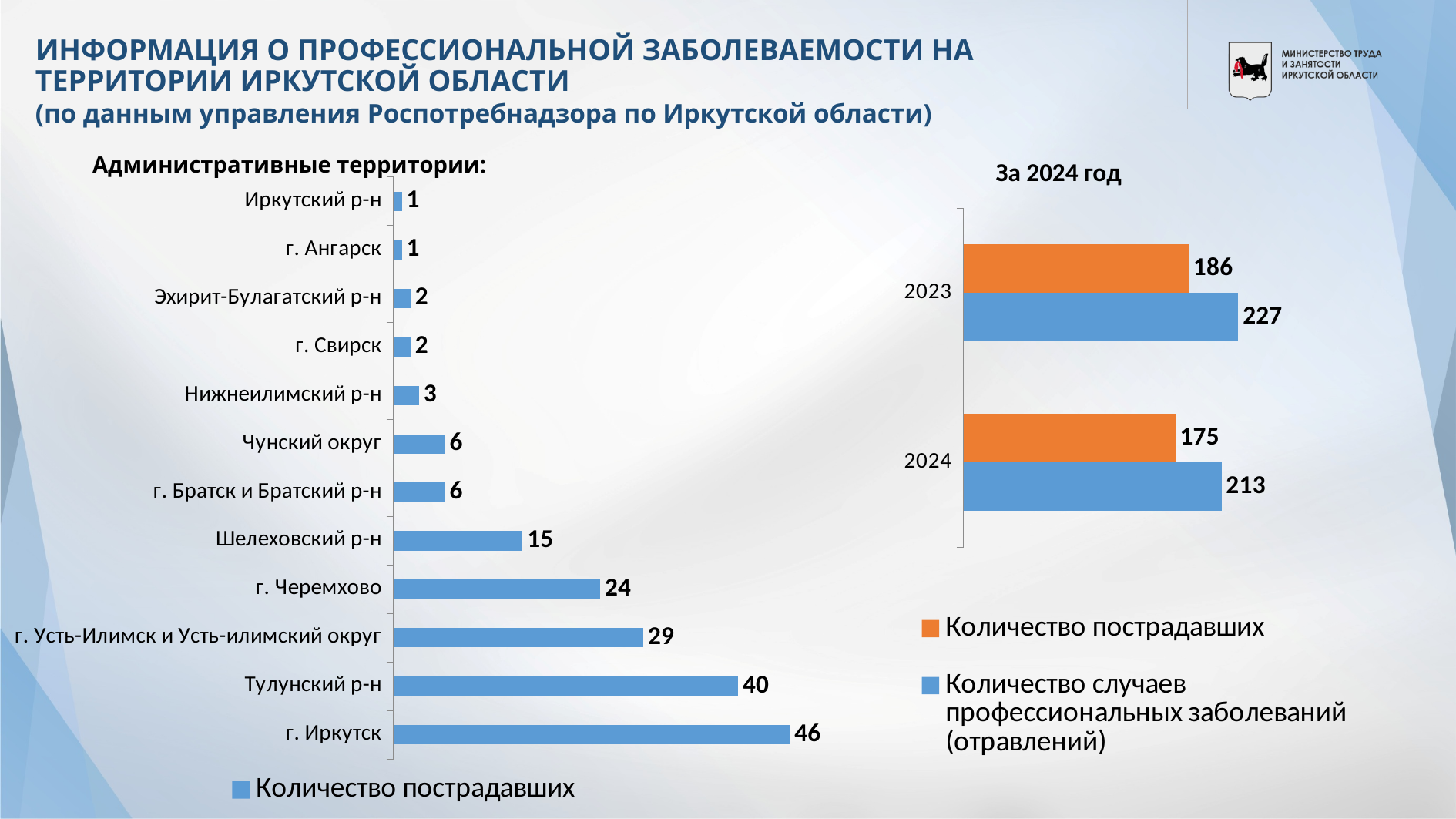
In the right chart 'За 2024 год', what is the value of Количество случаев профессиональных заболеваний (отравлений) for 2023? 227 In the left chart 'Административные территории', which territory has the highest value? г. Иркутск In the left chart 'Административные территории', what is the value for Шелеховский р-н? 15 In the right chart 'За 2024 год', did Количество случаев профессиональных заболеваний (отравлений) rise or fall from 2023 to 2024? fall What kind of chart is the left chart 'Административные территории'? bar chart In the left chart 'Административные территории', which is larger: г. Усть-Илимск и Усть-илимский округ or Шелеховский р-н? г. Усть-Илимск и Усть-илимский округ In the left chart 'Административные территории', what is the value for г. Иркутск? 46 In the left chart 'Административные территории', what is the difference between Тулунский р-н and г. Черемхово? 16 In the right chart 'За 2024 год', what is the difference in Количество пострадавших between 2023 and 2024? 11 How many series does the legend of the right chart 'За 2024 год' list? 2 In the right chart 'За 2024 год', what is the value of Количество пострадавших for 2024? 175 How many territories are shown in the left chart 'Административные территории'? 12